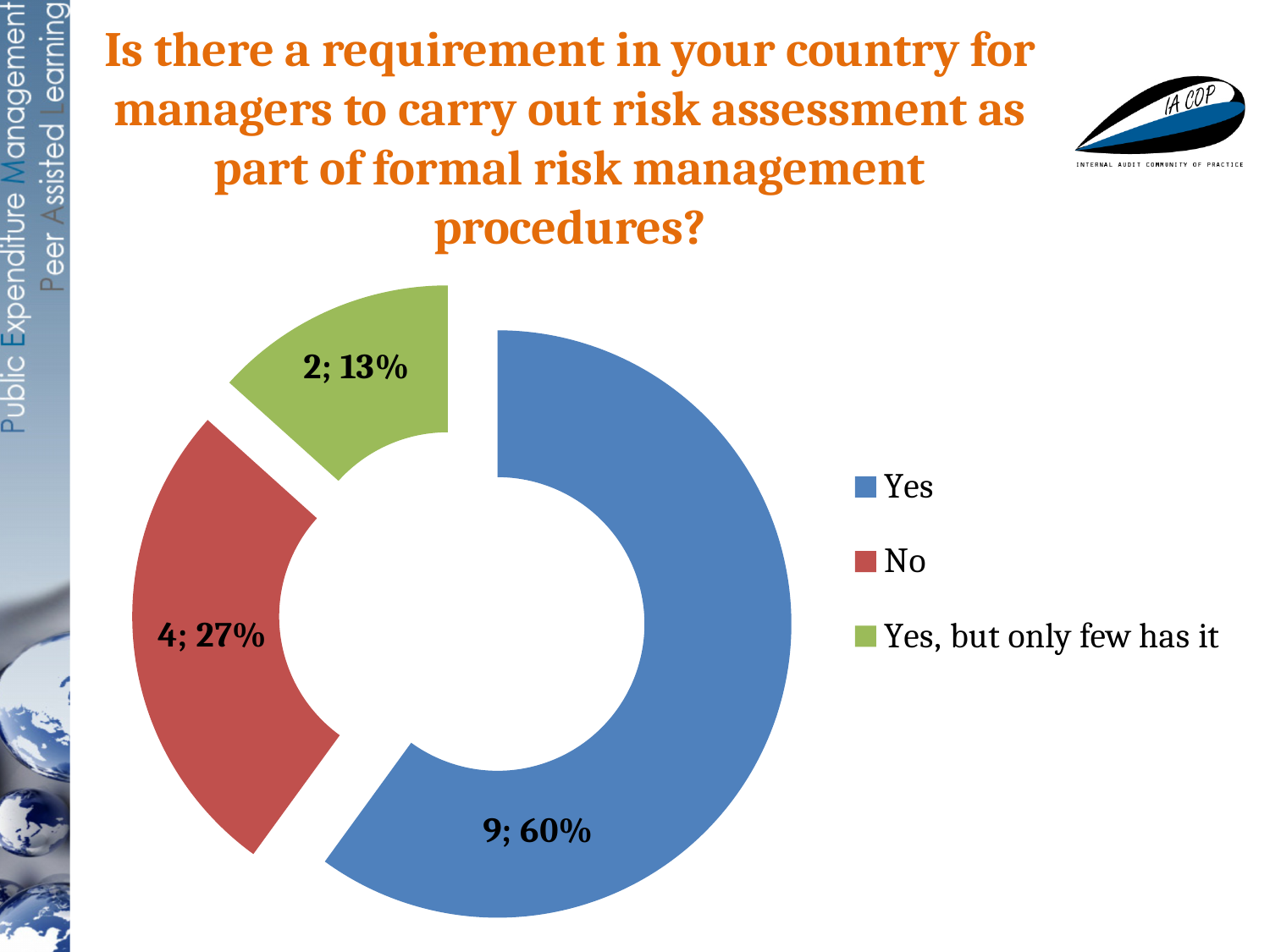
What colour is the "No" slice in the chart? Red What is the total number of responses across all categories? 15 What is the difference in the number of responses between "Yes" and "No"? 5 What percentage share does the "Yes" category have? 60% What kind of chart is shown on the slide? Doughnut (pie) chart Which category has more responses, "No" or "Yes, but only few has it"? No Which category has the largest share of the chart? Yes How many responses are in the "Yes, but only few has it" category? 2 How many responses are in the "Yes" category? 9 How many categories does the chart show? 3 What percentage share does the "No" category have? 27% Which category has the smallest share of the chart? Yes, but only few has it